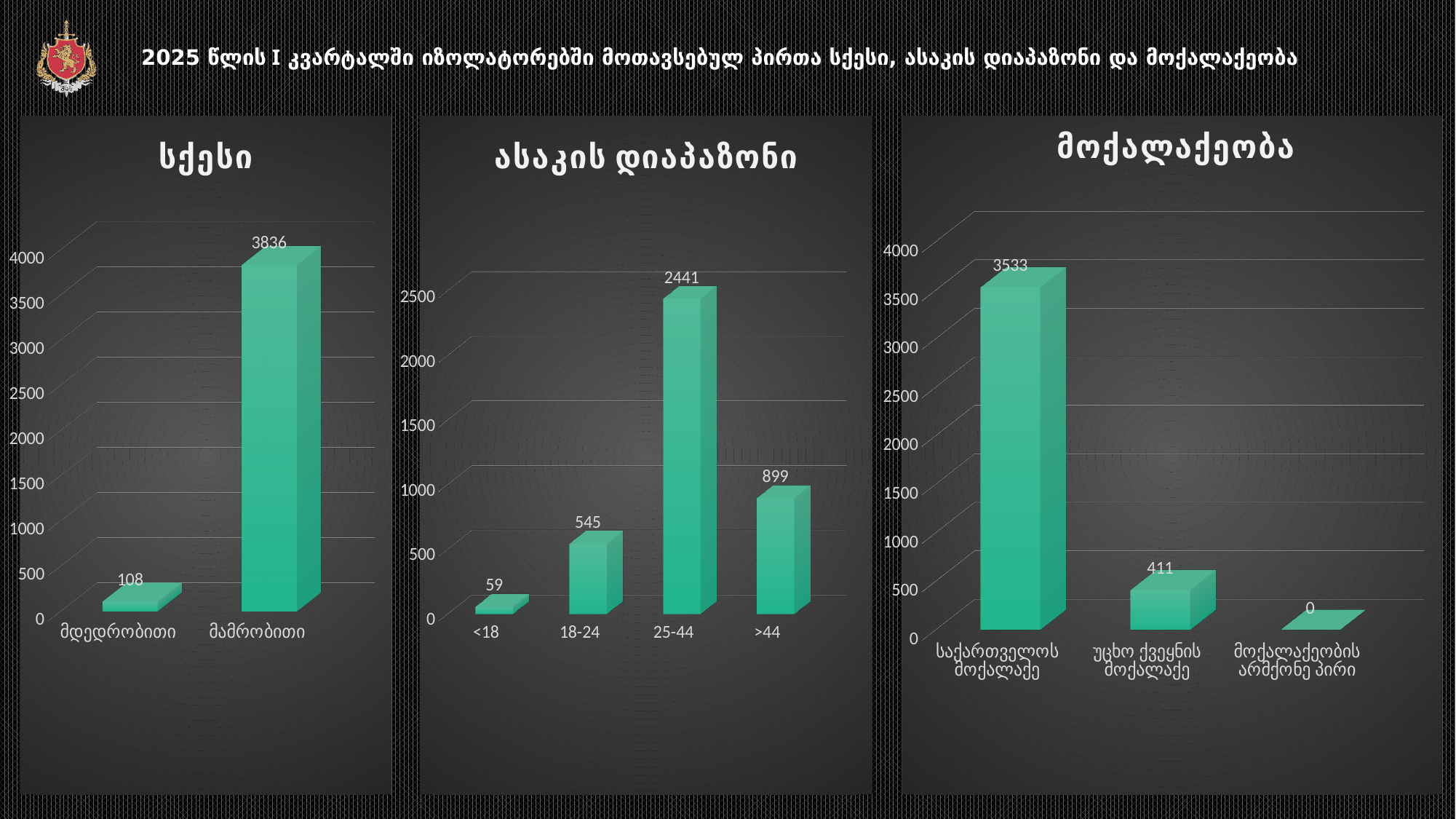
In the right chart titled "მოქალაქეობა", which category has the highest value? საქართველოს მოქალაქე In the left chart titled "სქესი", what is the difference between the values for მამრობითი and მდედრობითი? 3728 In the middle chart titled "ასაკის დიაპაზონი", which is larger, the value for 18-24 or the value for >44? >44 In the left chart titled "სქესი", what is the value for მდედრობითი? 108 In the right chart titled "მოქალაქეობა", what is the value for უცხო ქვეყნის მოქალაქე? 411 In the left chart titled "სქესი", what is the value for მამრობითი? 3836 In the right chart titled "მოქალაქეობა", what is the value for მოქალაქეობის არმქონე პირი? 0 In the middle chart titled "ასაკის დიაპაზონი", how many age categories are shown? 4 In the middle chart titled "ასაკის დიაპაზონი", what is the difference between the values for >44 and 18-24? 354 What type of chart is the right chart titled "მოქალაქეობა"? Bar chart In the middle chart titled "ასაკის დიაპაზონი", what is the value for the 25-44 category? 2441 In the middle chart titled "ასაკის დიაპაზონი", which category has the lowest value? <18